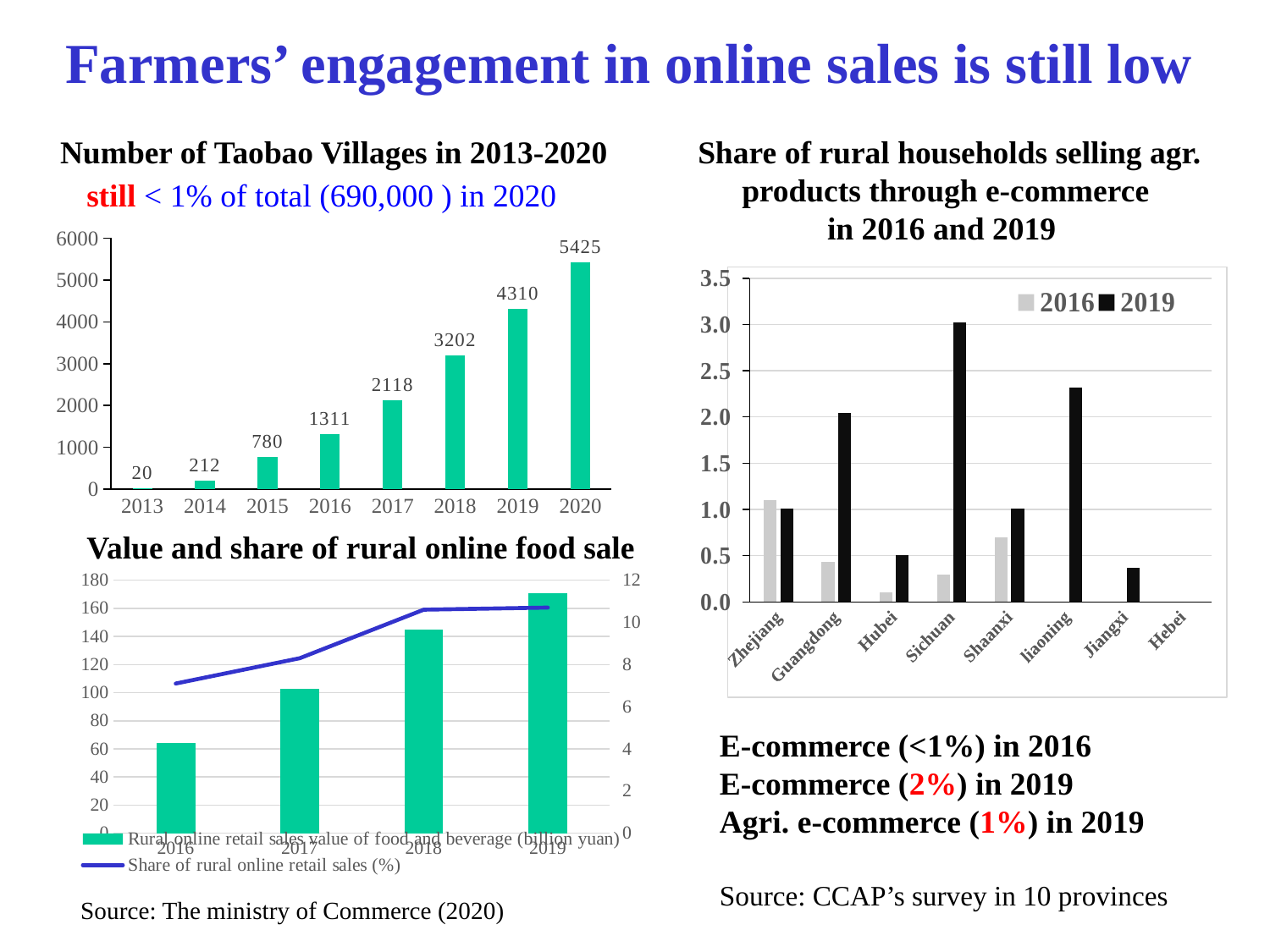
In the 'Number of Taobao Villages in 2013-2020' chart, how many years are shown on the x axis? 8 In the 'Value and share of rural online food sale' chart, how many series does the legend list? 2 In the 'Value and share of rural online food sale' chart, is the bar value for 2016 greater or less than 80? less In the 'Share of rural households selling agr. products through e-commerce' chart, which province has the highest 2019 value? Sichuan In the 'Number of Taobao Villages in 2013-2020' chart, what is the difference between the values for 2020 and 2019? 1115 In the 'Number of Taobao Villages in 2013-2020' chart, do the values rise or fall from 2013 to 2020? rise What kind of chart is the 'Number of Taobao Villages in 2013-2020' chart? bar chart In the 'Value and share of rural online food sale' chart, which year has the larger bar, 2016 or 2019? 2019 In the 'Share of rural households selling agr. products through e-commerce' chart, what are the two legend entries? 2016 and 2019 In the 'Number of Taobao Villages in 2013-2020' chart, which year has the highest value? 2020 In the 'Share of rural households selling agr. products through e-commerce' chart, is the 2019 value for Sichuan greater or less than 2.5? greater In the 'Number of Taobao Villages in 2013-2020' chart, what is the value for 2018? 3202